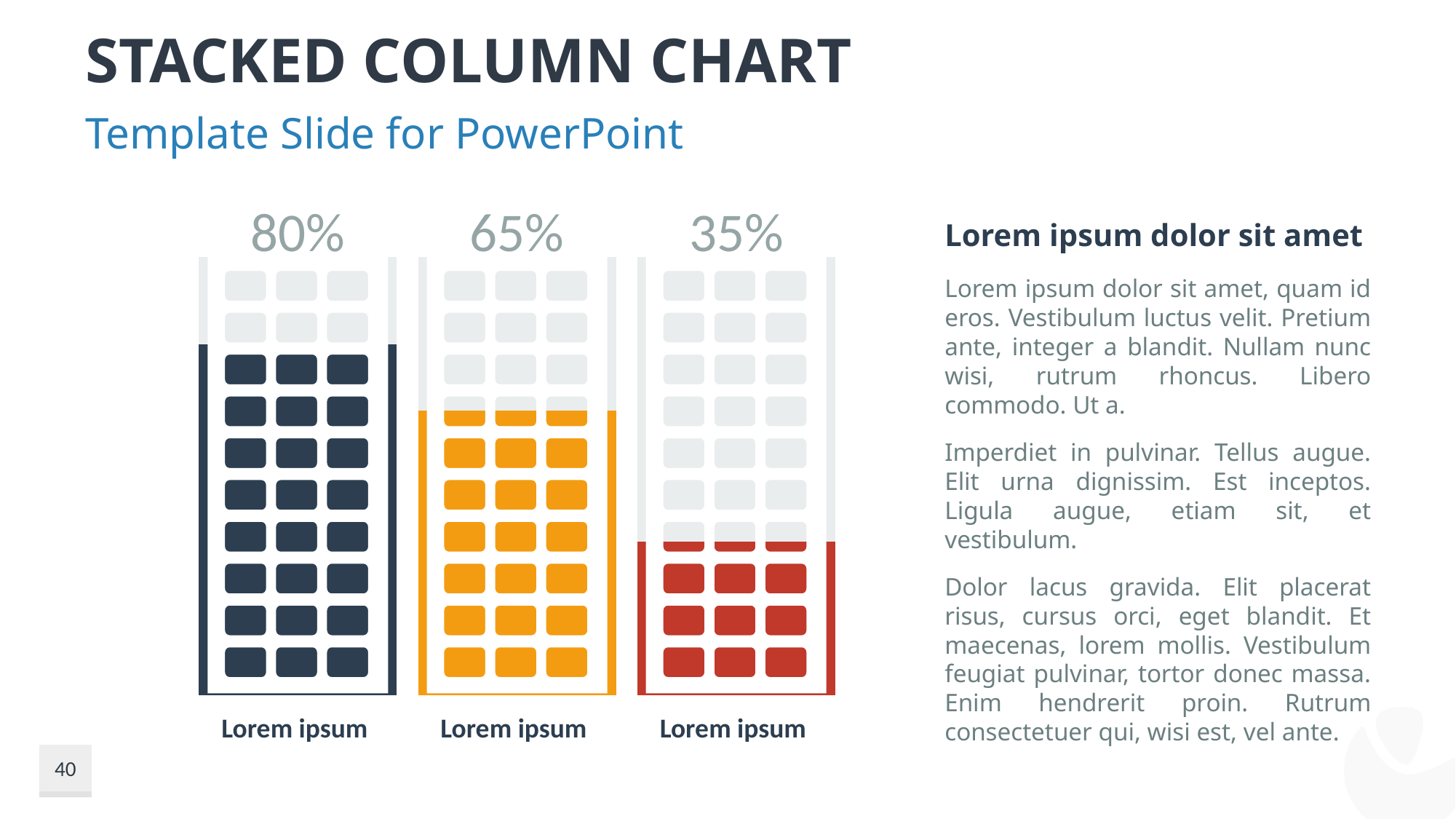
What is the title of the slide containing the chart? STACKED COLUMN CHART What is the difference between the left bar's value and the right bar's value? 45 percentage points Which bar has the highest value? The left (dark blue) bar, 80% What is the difference between the left bar's value and the middle bar's value? 15 percentage points What is the difference between the middle bar's value and the right bar's value? 30 percentage points Which bar has the lowest value? The right (red) bar, 35% What value is shown above the left (dark blue) bar? 80% Which is larger, the value of the orange bar or the value of the red bar? The orange bar (65%) Do the values rise or fall from left to right across the bars? Fall How many bars are shown in the chart? 3 What value is shown above the right (red) bar? 35% What value is shown above the middle (orange) bar? 65%